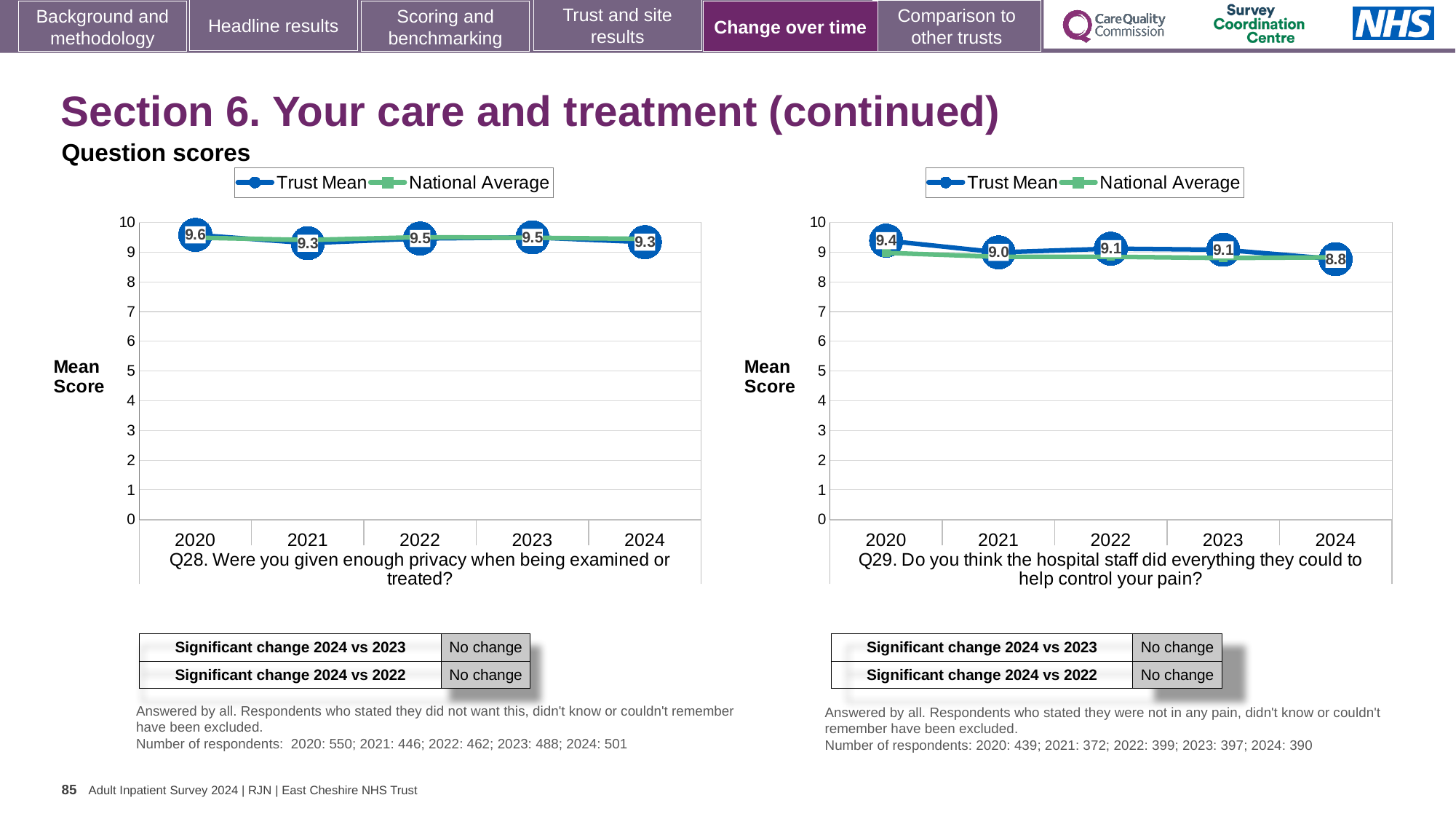
In the Q28 chart (left), what is the difference between the Trust Mean scores for 2020 and 2021? 0.3 In the Q29 chart (right), what is the Trust Mean score for 2021? 9.0 In the Q29 chart (right), which year has the lowest Trust Mean score? 2024 In the Q29 chart (right), what is the Trust Mean score for 2024? 8.8 Which is higher: the 2024 Trust Mean in the Q28 chart (left) or the 2024 Trust Mean in the Q29 chart (right)? Q28 chart (left) In the Q28 chart (left), which year has the highest Trust Mean score? 2020 In the Q28 chart (left), what is the Trust Mean score for 2024? 9.3 In the Q29 chart (right), what is the difference between the Trust Mean scores for 2020 and 2024? 0.6 How many series does the legend of the Q28 chart (left) list? 2 How many years are plotted on the x axis of the Q29 chart (right)? 5 What type of chart is used for Q28 (left)? Line chart In the Q28 chart (left), what is the Trust Mean score for 2020? 9.6